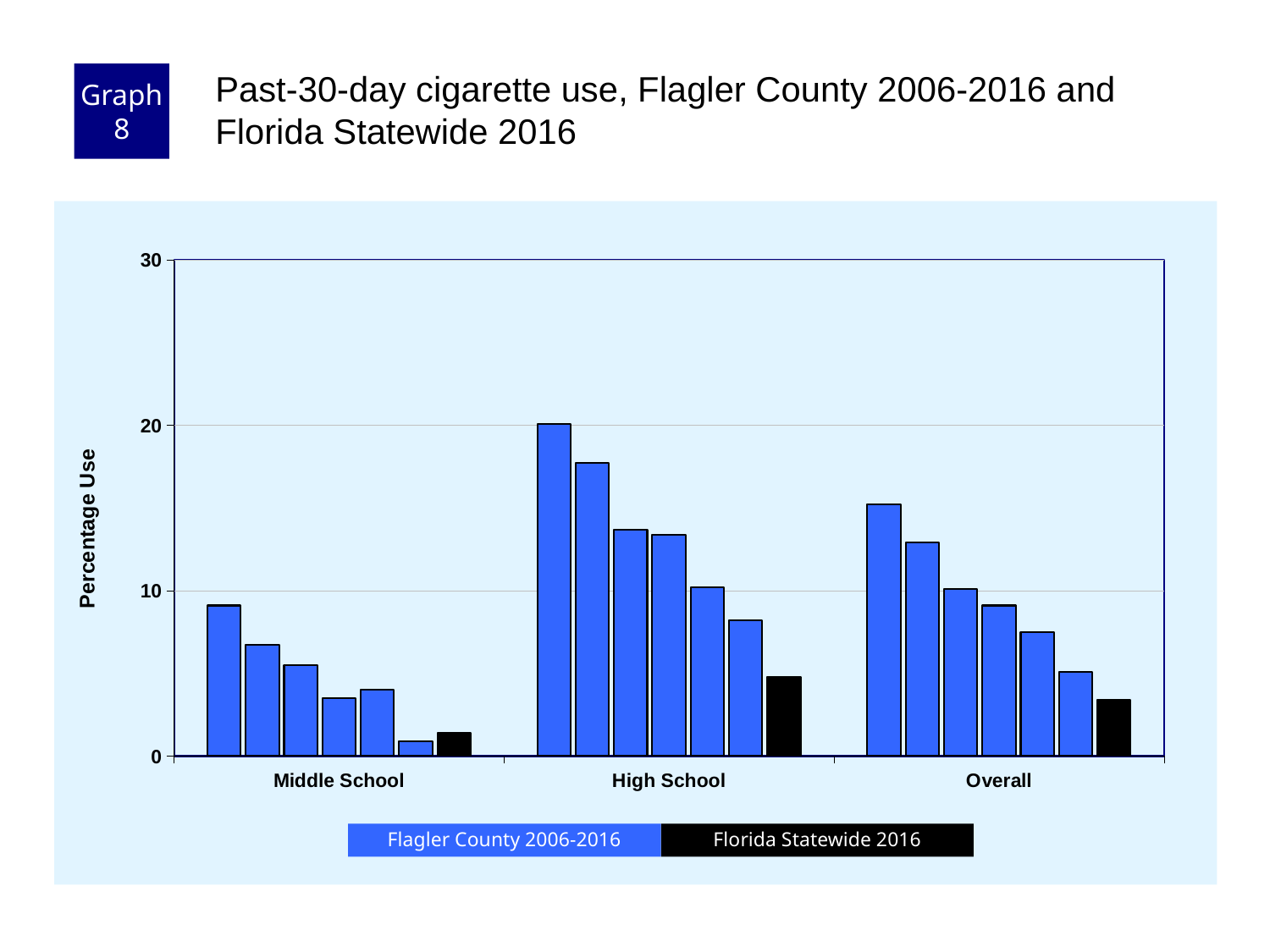
What colour represents Florida Statewide 2016 in the legend? black What kind of chart is shown on the slide? bar chart Is the Florida Statewide 2016 value for High School greater or less than 10? less What is the label on the y axis? Percentage Use Within the High School category, do the Flagler County 2006-2016 bars rise or fall from left to right? fall Which category has the lowest Florida Statewide 2016 value? Middle School Is the tallest Flagler County 2006-2016 bar for Overall greater or less than 10? greater How many series does the legend list? 2 Which category has the tallest bar in the chart? High School Which is larger, the Florida Statewide 2016 value for High School or for Middle School? High School Is the tallest Flagler County 2006-2016 bar for Middle School greater or less than 10? less How many categories are shown on the x axis? 3